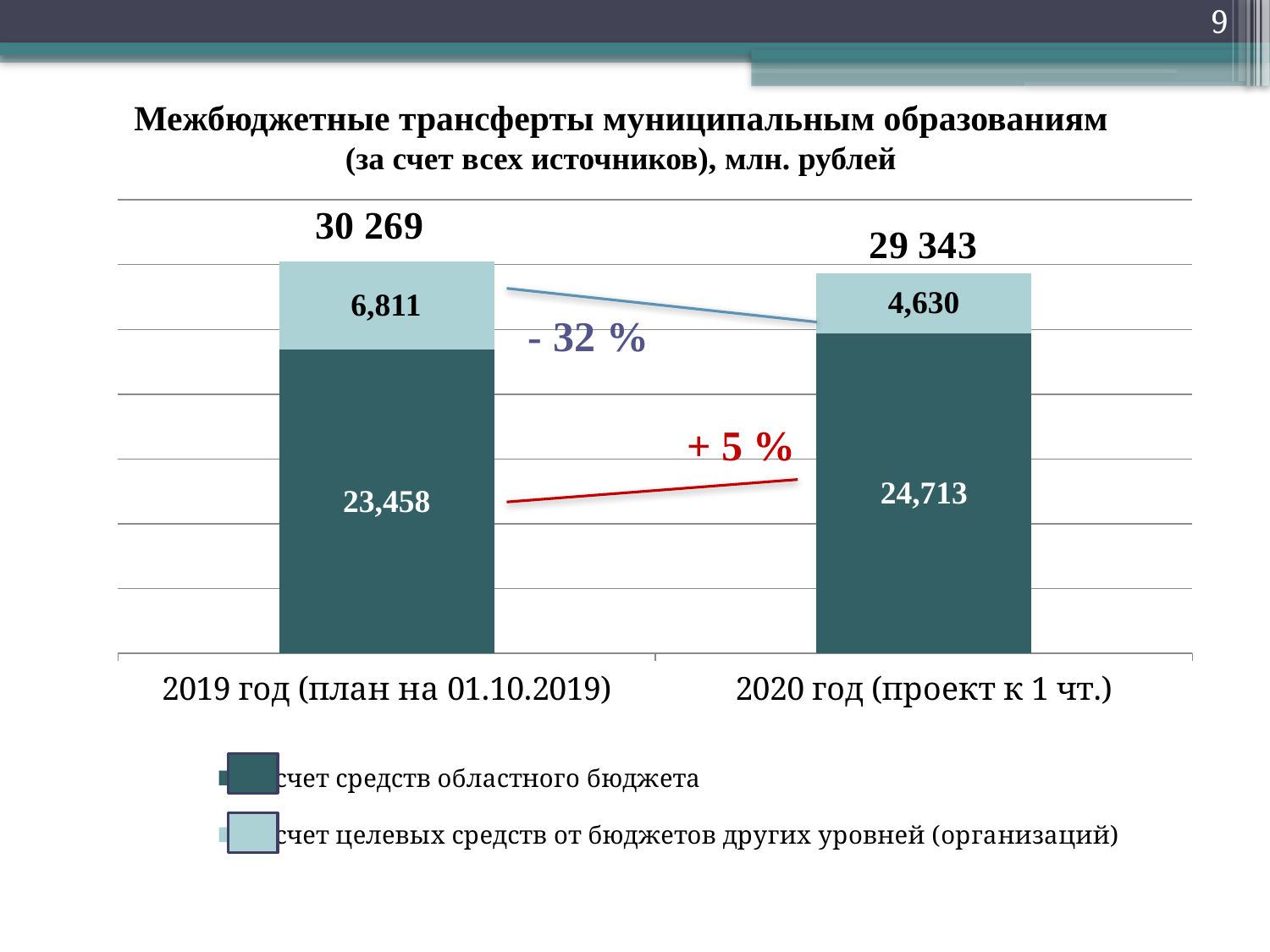
By how much does the regional budget segment (средств областного бюджета) in 2020 exceed that in 2019? 1,255 Which year has the larger regional budget segment (средств областного бюджета), 2019 or 2020? 2020 год (проект к 1 чт.) What is the total shown above the bar for 2020 год (проект к 1 чт.)? 29 343 What is the value of the regional budget segment (средств областного бюджета) for 2019 год (план на 01.10.2019)? 23,458 What is the difference between the targeted funds segment in 2019 (6,811) and in 2020 (4,630)? 2,181 What percentage change is annotated for the regional budget segment between 2019 and 2020? + 5 % How many categories (years) are shown on the x axis? 2 What is the total shown above the bar for 2019 год (план на 01.10.2019)? 30 269 What kind of chart is shown on the slide? Stacked bar chart What percentage change is annotated for the targeted funds segment between 2019 and 2020? - 32 % What is the value of the targeted funds segment (целевых средств от бюджетов других уровней) for 2020 год (проект к 1 чт.)? 4,630 How many series does the legend list? 2